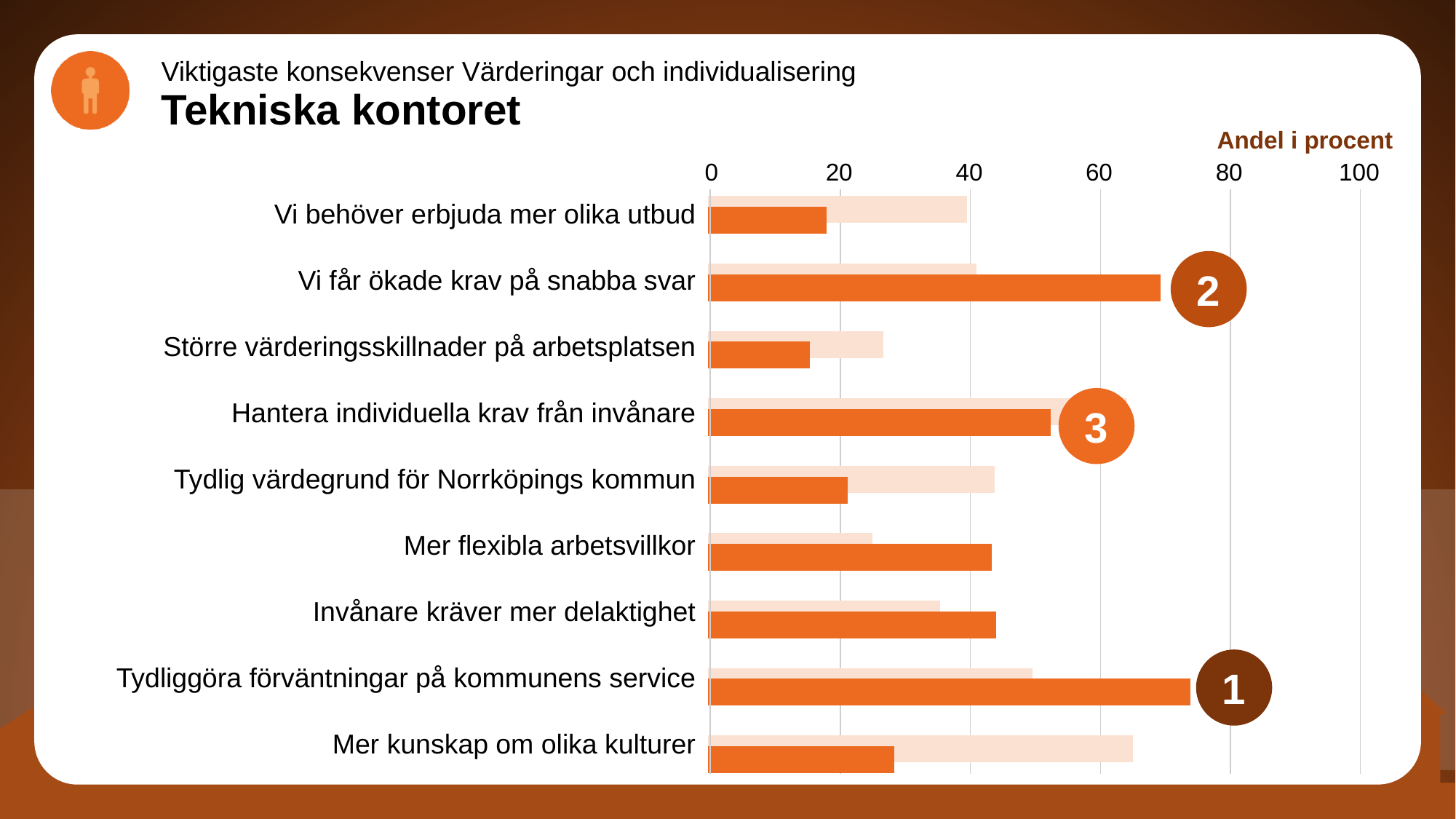
Is the dark orange bar for 'Tydlig värdegrund för Norrköpings kommun' greater or less than 40? less Is the dark orange bar for 'Vi behöver erbjuda mer olika utbud' greater or less than 20? less Is the dark orange bar for 'Vi får ökade krav på snabba svar' greater or less than 60? greater What kind of chart is shown on the slide? bar chart For 'Mer kunskap om olika kulturer', which bar is longer: the dark orange bar or the light bar? the light bar How many categories are listed on the chart? 9 Which category has the longest dark orange bar? Tydliggöra förväntningar på kommunens service Which has the longer dark orange bar: 'Tydliggöra förväntningar på kommunens service' or 'Hantera individuella krav från invånare'? Tydliggöra förväntningar på kommunens service Which category is marked with the circle labelled '1'? Tydliggöra förväntningar på kommunens service What label is shown above the horizontal axis of the chart? Andel i procent